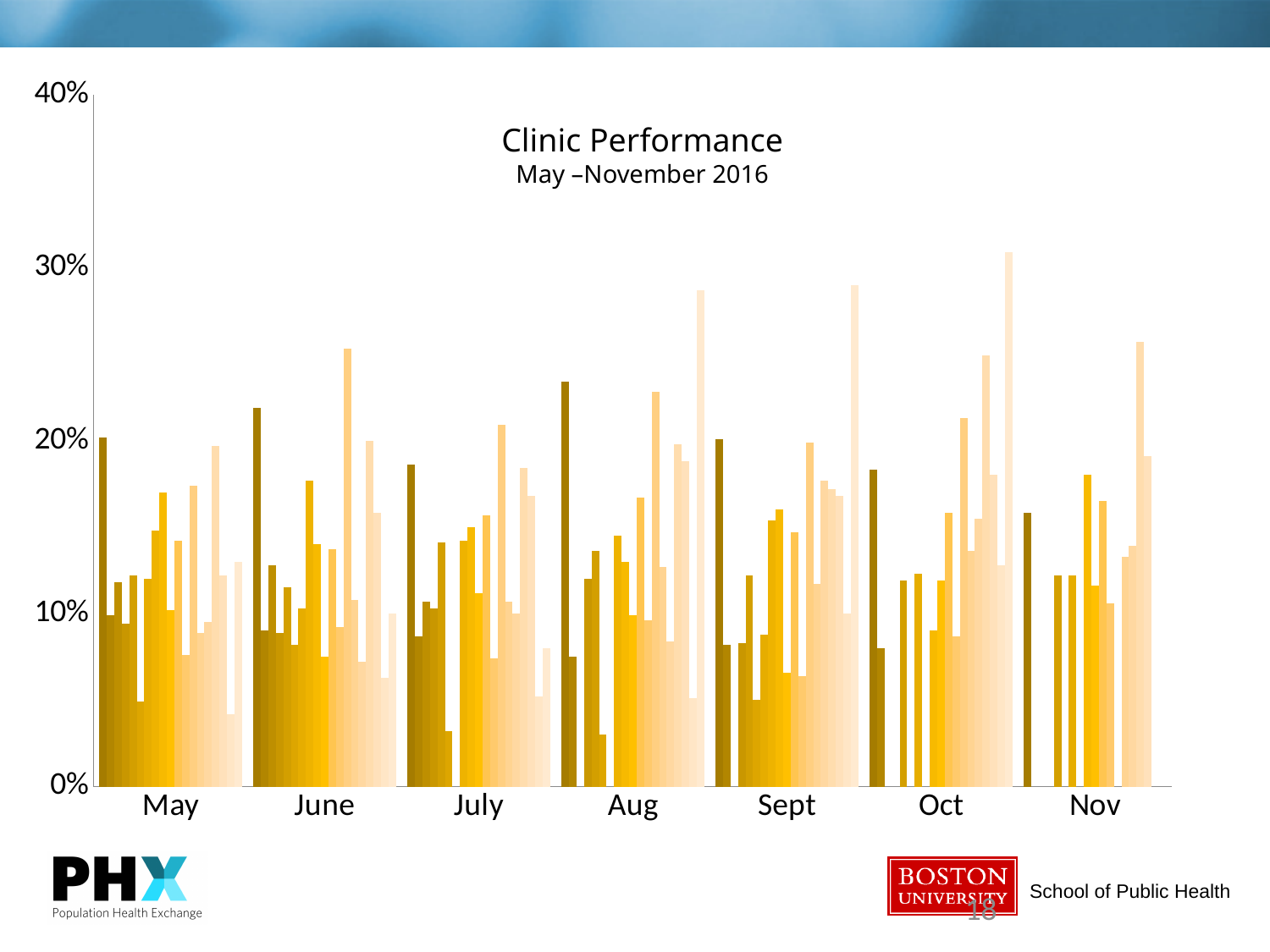
Is the tallest bar in June greater or less than 20%? greater What is the title of the chart? Clinic Performance Is the tallest bar in Sept greater or less than 30%? less Is the tallest bar in Oct greater or less than 30%? greater What period does the chart's subtitle say the data covers? May –November 2016 What is the highest value shown on the y axis? 40% How many months are shown along the x axis of the chart? 7 Which month contains the tallest bar in the chart? Oct What kind of chart is shown on the slide? Bar chart